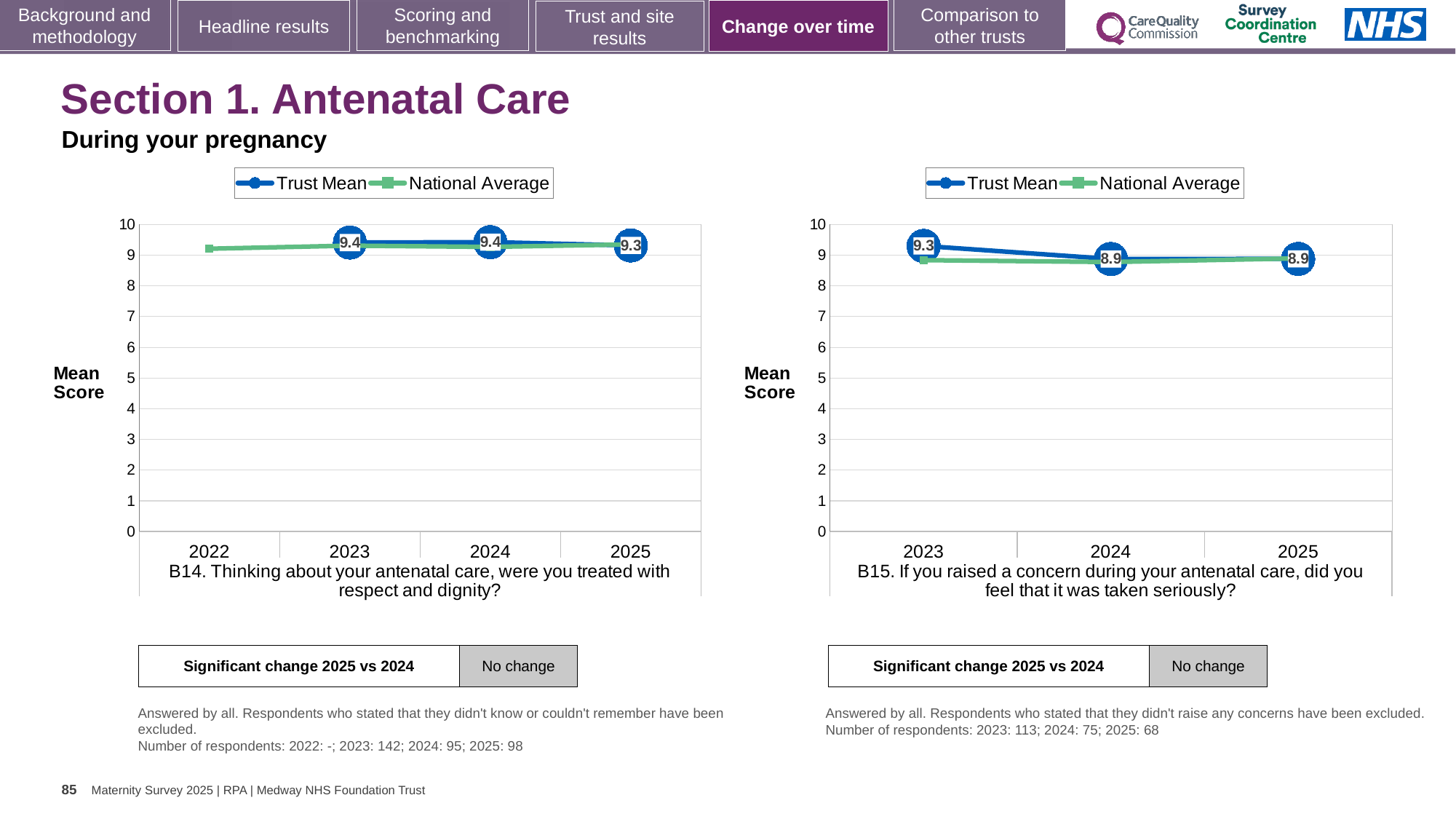
On the left chart (B14), what is the Trust Mean score for 2025? 9.3 On the right chart (B15), what is the Trust Mean score for 2024? 8.9 How many years are shown on the x axis of the left chart (B14)? 4 On the right chart (B15), is the Trust Mean score for 2025 greater or less than 9? less How many series does the legend of the right chart (B15) list? 2 On the left chart (B14), is the Trust Mean score for 2024 greater or less than 9? greater On the right chart (B15), what is the Trust Mean score for 2023? 9.3 On the right chart (B15), does the Trust Mean score rise or fall from 2023 to 2024? Fall On the right chart (B15), what is the difference between the Trust Mean score in 2023 and in 2024? 0.4 On the left chart (B14), what is the Trust Mean score for 2023? 9.4 What kind of chart is the left chart (B14)? Line chart On the right chart (B15), which year has the highest Trust Mean score? 2023